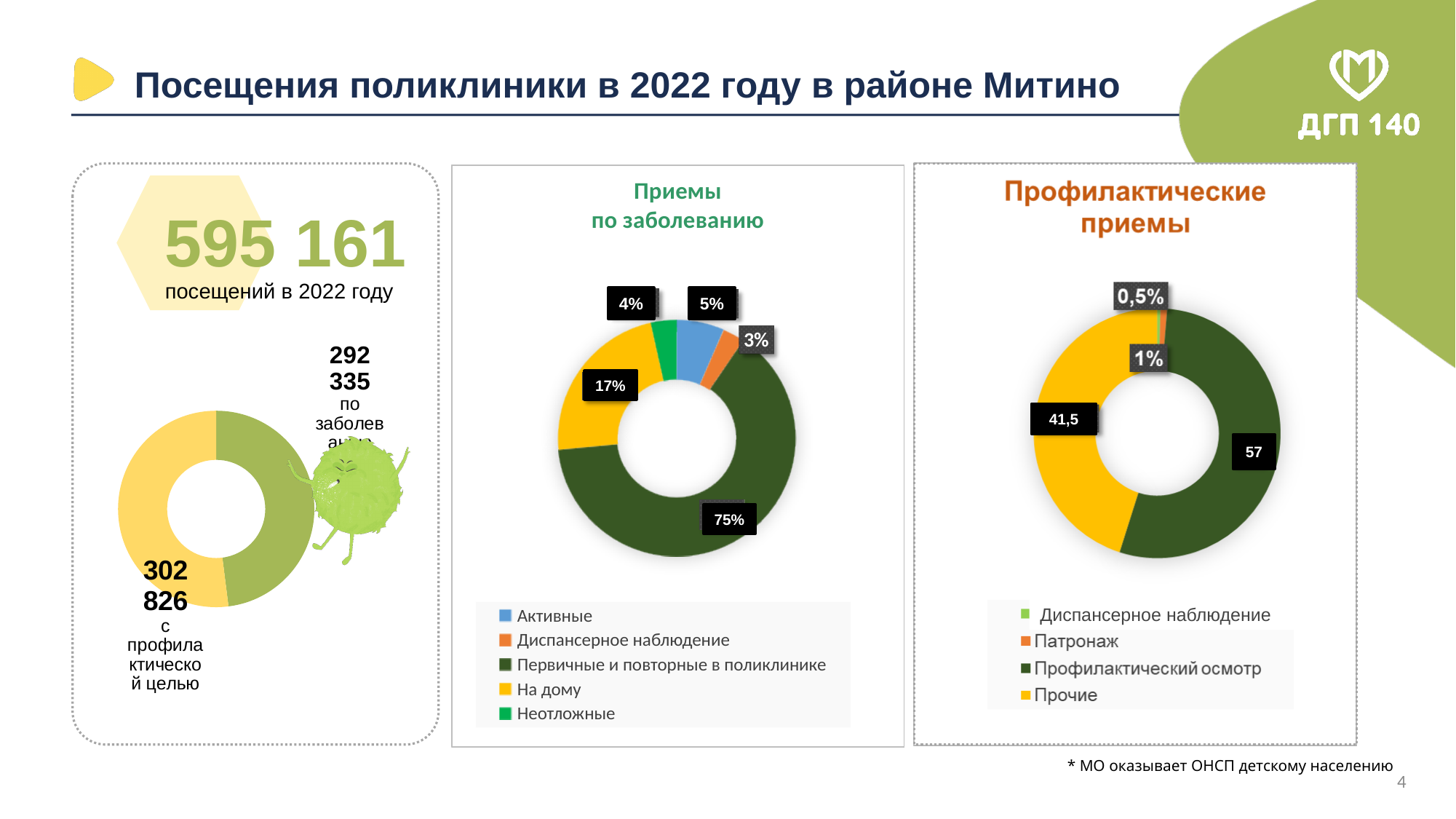
In the chart titled "Приемы по заболеванию", how many categories does the legend list? 5 In the chart titled "Профилактические приемы", what value is shown for "Прочие"? 41,5 In the chart titled "Приемы по заболеванию", what percentage is shown for "На дому"? 17% In the donut chart on the left of the slide, what value is shown for visits "по заболеванию"? 292 335 In the chart titled "Профилактические приемы", which is larger: "Патронаж" or "Диспансерное наблюдение"? Патронаж In the chart titled "Приемы по заболеванию", what is the difference in percentage points between "Активные" and "Неотложные"? 1 In the chart titled "Приемы по заболеванию", which category has the smallest share? Диспансерное наблюдение In the chart titled "Профилактические приемы", what value is shown for "Профилактический осмотр"? 57 In the chart titled "Приемы по заболеванию", what percentage is shown for "Первичные и повторные в поликлинике"? 75% What kind of chart is used in the panel titled "Профилактические приемы"? Donut (pie) chart In the chart titled "Профилактические приемы", which category has the smallest share? Диспансерное наблюдение In the chart titled "Приемы по заболеванию", which category has the largest share? Первичные и повторные в поликлинике